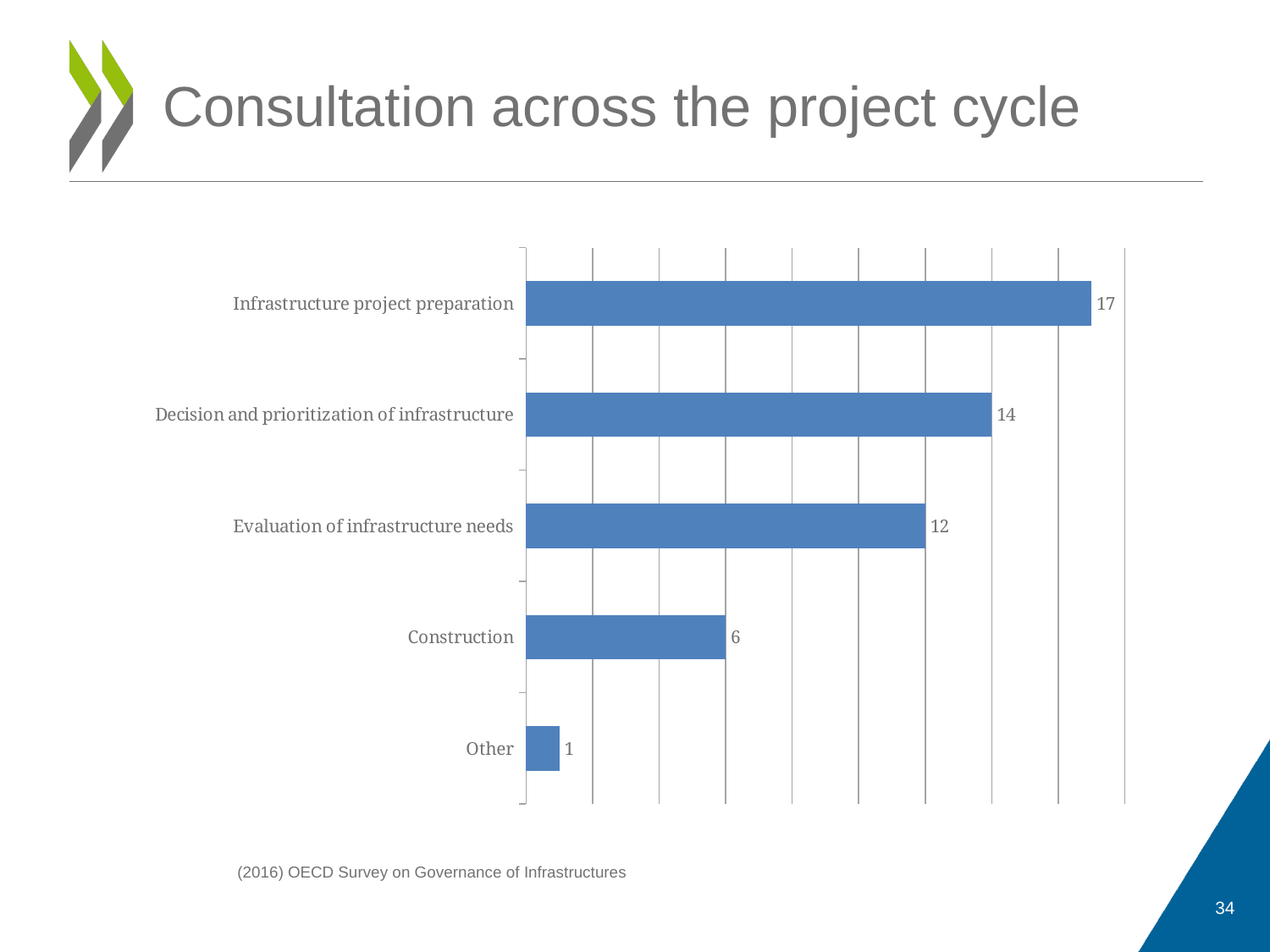
Which category has the highest value? Infrastructure project preparation What is the value for Construction? 6 What is the value for Infrastructure project preparation? 17 What is the value for Evaluation of infrastructure needs? 12 What kind of chart is shown on the slide? Bar chart Which is larger, the value for Evaluation of infrastructure needs or the value for Construction? Evaluation of infrastructure needs What is the difference between the values for Infrastructure project preparation and Construction? 11 What is the value for Other? 1 What is the difference between the values for Decision and prioritization of infrastructure and Evaluation of infrastructure needs? 2 What is the value for Decision and prioritization of infrastructure? 14 Which category has the lowest value? Other How many categories are shown in the chart? 5